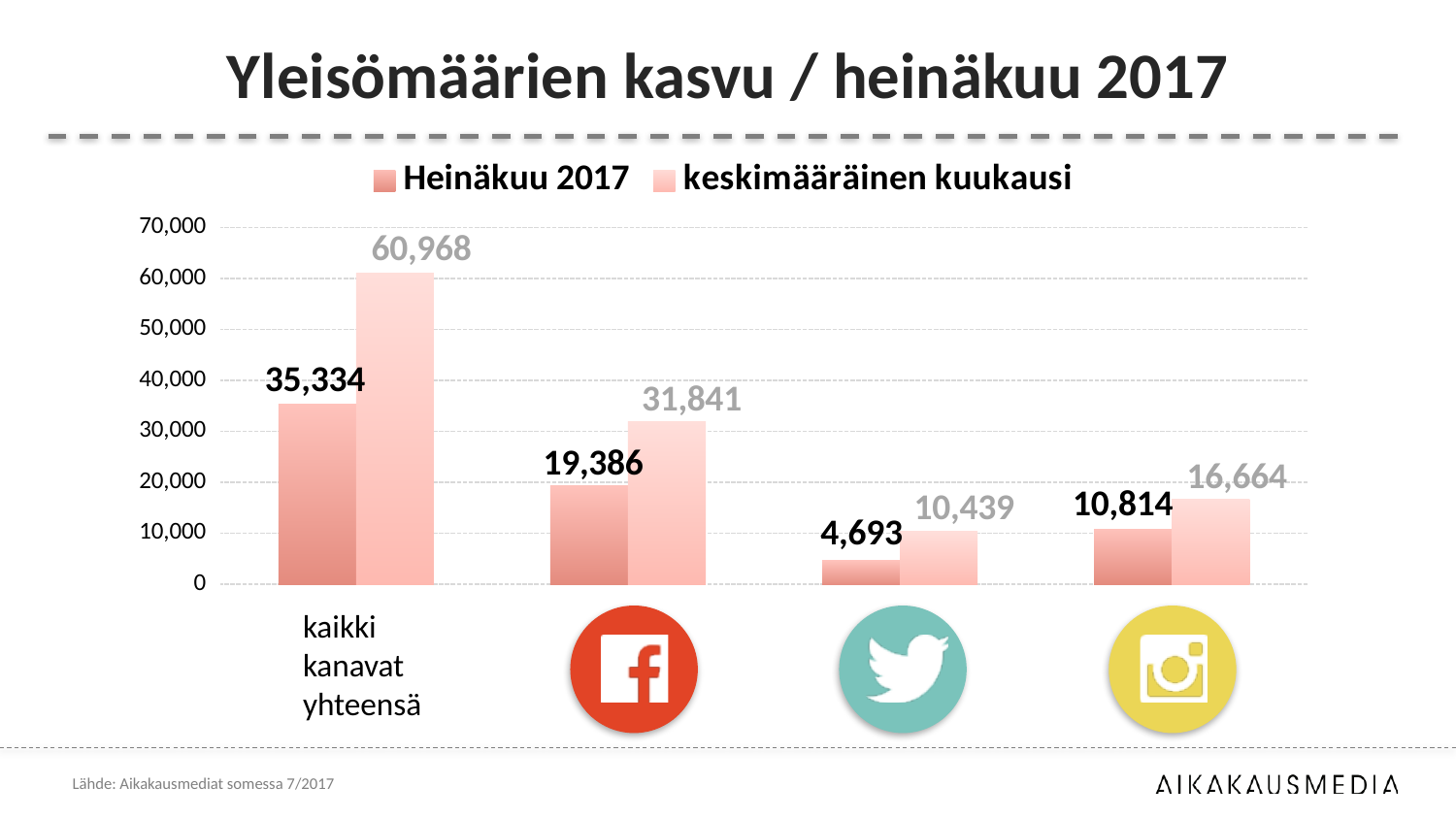
What is the difference between the keskimääräinen kuukausi and Heinäkuu 2017 values for the Instagram category? 5,850 What are the two series named in the legend? Heinäkuu 2017 and keskimääräinen kuukausi What kind of chart is shown on the slide? bar chart How many categories are shown on the x axis? 4 What is the keskimääräinen kuukausi value for kaikki kanavat yhteensä? 60,968 What is the title of the chart slide? Yleisömäärien kasvu / heinäkuu 2017 What is the Heinäkuu 2017 value for the Facebook category? 19,386 What is the Heinäkuu 2017 value for kaikki kanavat yhteensä? 35,334 What is the keskimääräinen kuukausi value for the Twitter category? 10,439 Which category has the lowest Heinäkuu 2017 value? Twitter Which is larger for the Facebook category: the Heinäkuu 2017 value or the keskimääräinen kuukausi value? keskimääräinen kuukausi How many series does the legend list? 2